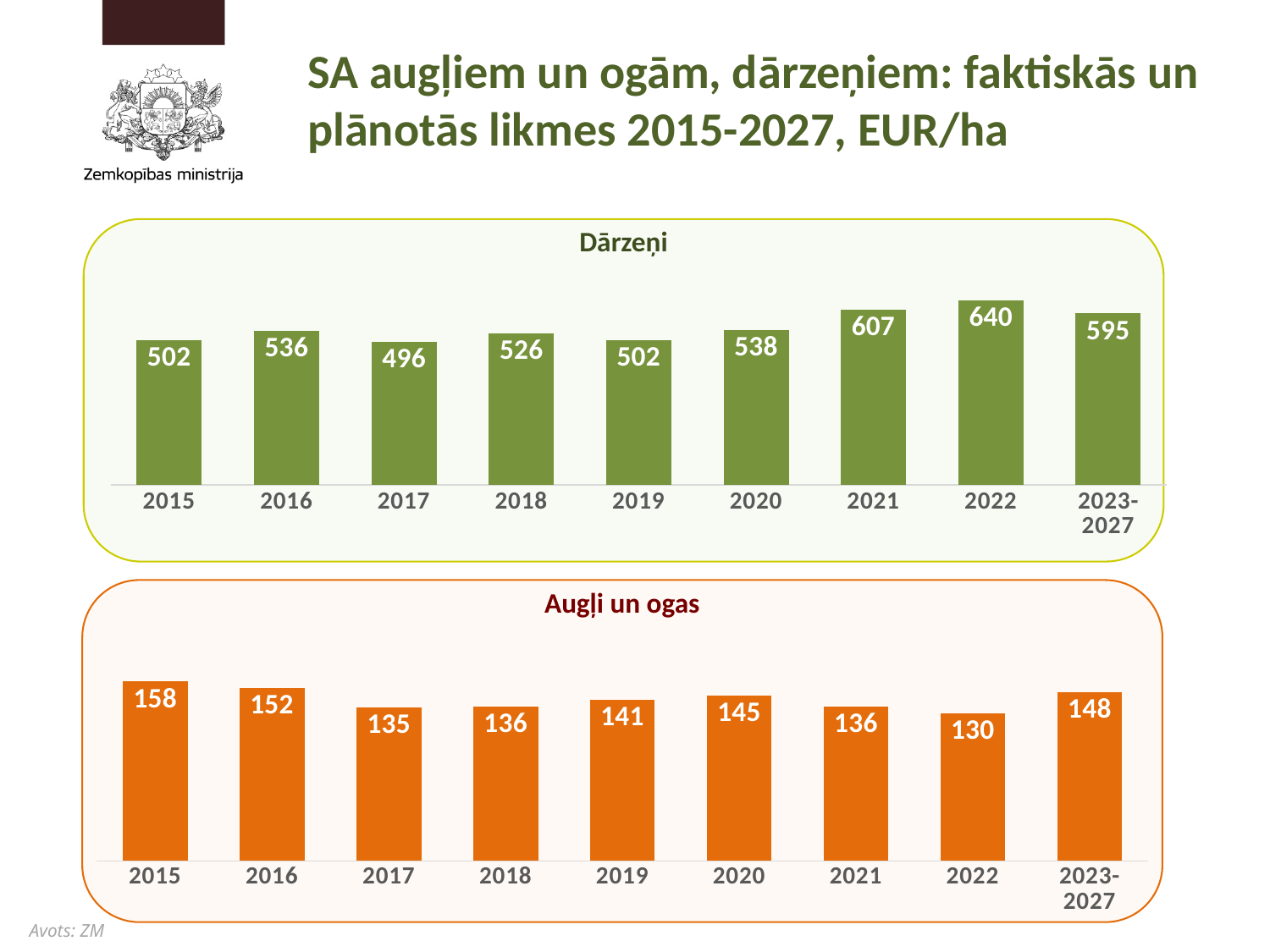
In the Augļi un ogas chart, what is the difference between the values for 2015 and 2022? 28 What colour are the bars in the Augļi un ogas chart? orange In the Dārzeņi chart, which is larger, the value for 2016 or the value for 2018? 2016 What kind of chart is the Dārzeņi chart? bar chart In the Dārzeņi chart, what is the difference between the values for 2022 and 2021? 33 In the Dārzeņi chart, which year has the lowest value? 2017 In the Augļi un ogas chart, which year has the lowest value? 2022 In the Augļi un ogas chart, what is the value for 2023-2027? 148 In the Augļi un ogas chart, which year has the highest value? 2015 In the Dārzeņi chart, which year has the highest value? 2022 How many categories are shown on the x axis of the Augļi un ogas chart? 9 In the Dārzeņi chart, what is the value for 2022? 640